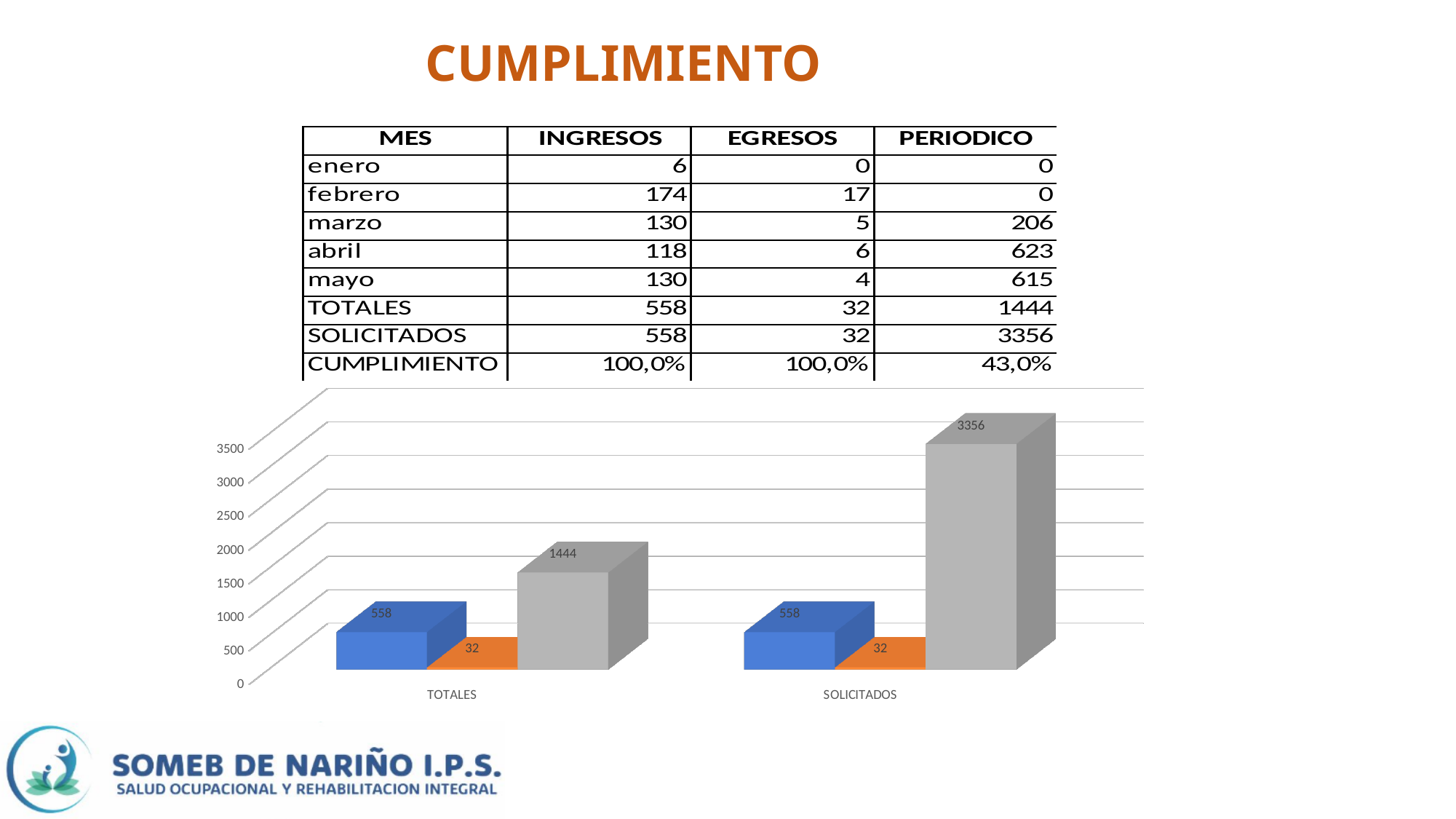
What is the difference between the gray bar for SOLICITADOS and the gray bar for TOTALES? 1912 Which is larger in the chart: the gray bar for TOTALES or the blue bar for TOTALES? the gray bar for TOTALES Which bar in the chart has the highest value? the gray bar for SOLICITADOS What is the difference between the blue bar and the orange bar for TOTALES? 526 What is the value of the orange bar for SOLICITADOS in the chart? 32 What is the value of the gray bar for SOLICITADOS in the chart? 3356 Is the value of the gray bar for SOLICITADOS greater or less than 3000? greater What is the value of the gray bar for TOTALES in the chart? 1444 How many categories are shown on the x axis of the chart? 2 What is the value of the blue bar for TOTALES in the chart? 558 What are the two category labels on the x axis of the chart? TOTALES and SOLICITADOS What kind of chart is shown on the slide? bar chart